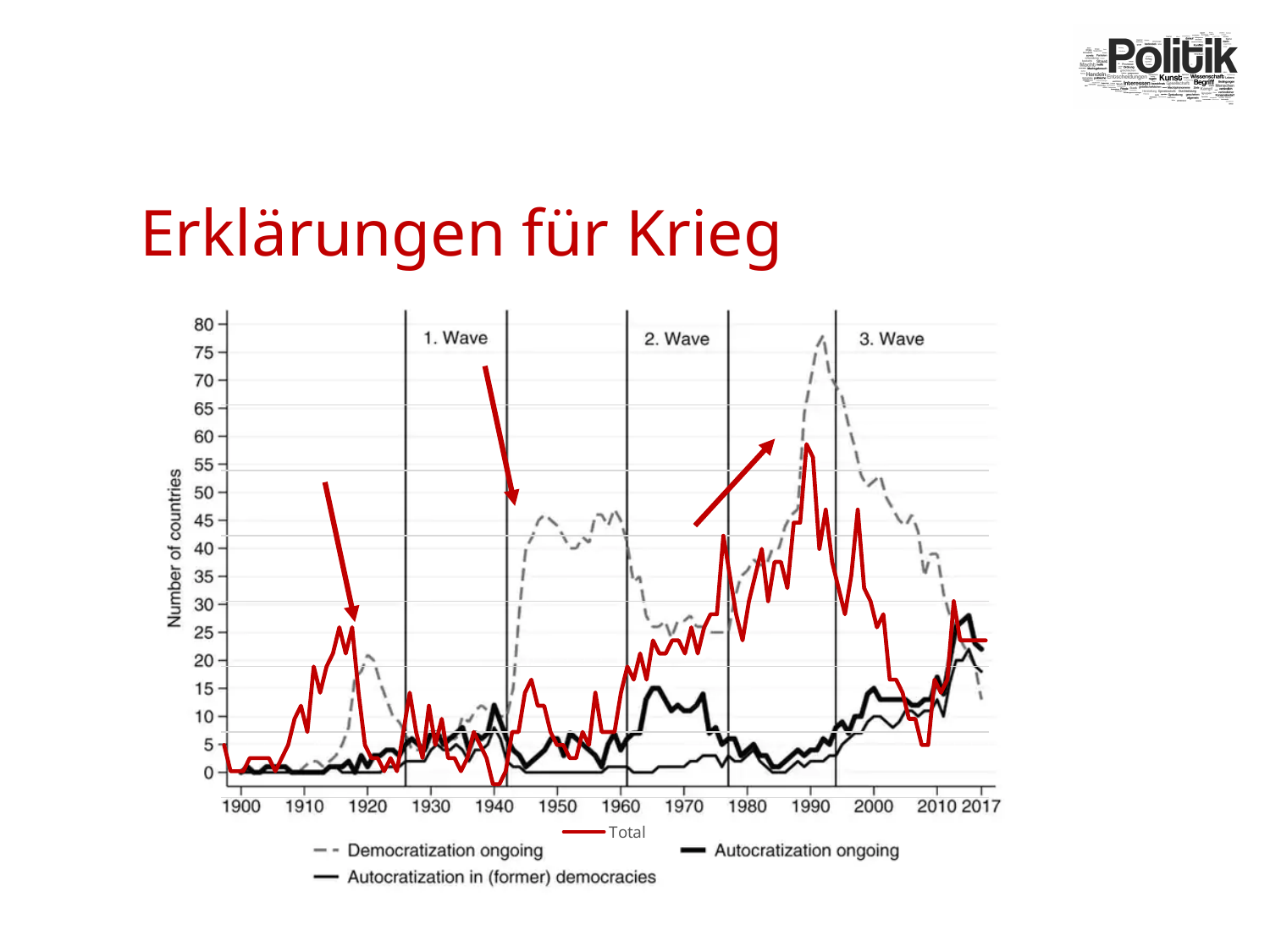
Is the value of the Autocratization ongoing series around 1990 greater or less than 10? less What kind of chart is shown on the slide? line chart Is the value of the Democratization ongoing series around 1950 greater or less than 40? greater How many wave periods are labelled on the chart? 3 Which series reaches the highest value anywhere on the chart? Democratization ongoing How many series does the legend list? 4 Around 1990, which is larger: Democratization ongoing or Autocratization ongoing? Democratization ongoing Is the peak value of the Total series around 1989 greater or less than 50? greater What is the label of the y axis? Number of countries Does the Democratization ongoing series rise or fall between 1992 and 2017? fall Which series is drawn as a dashed grey line? Democratization ongoing